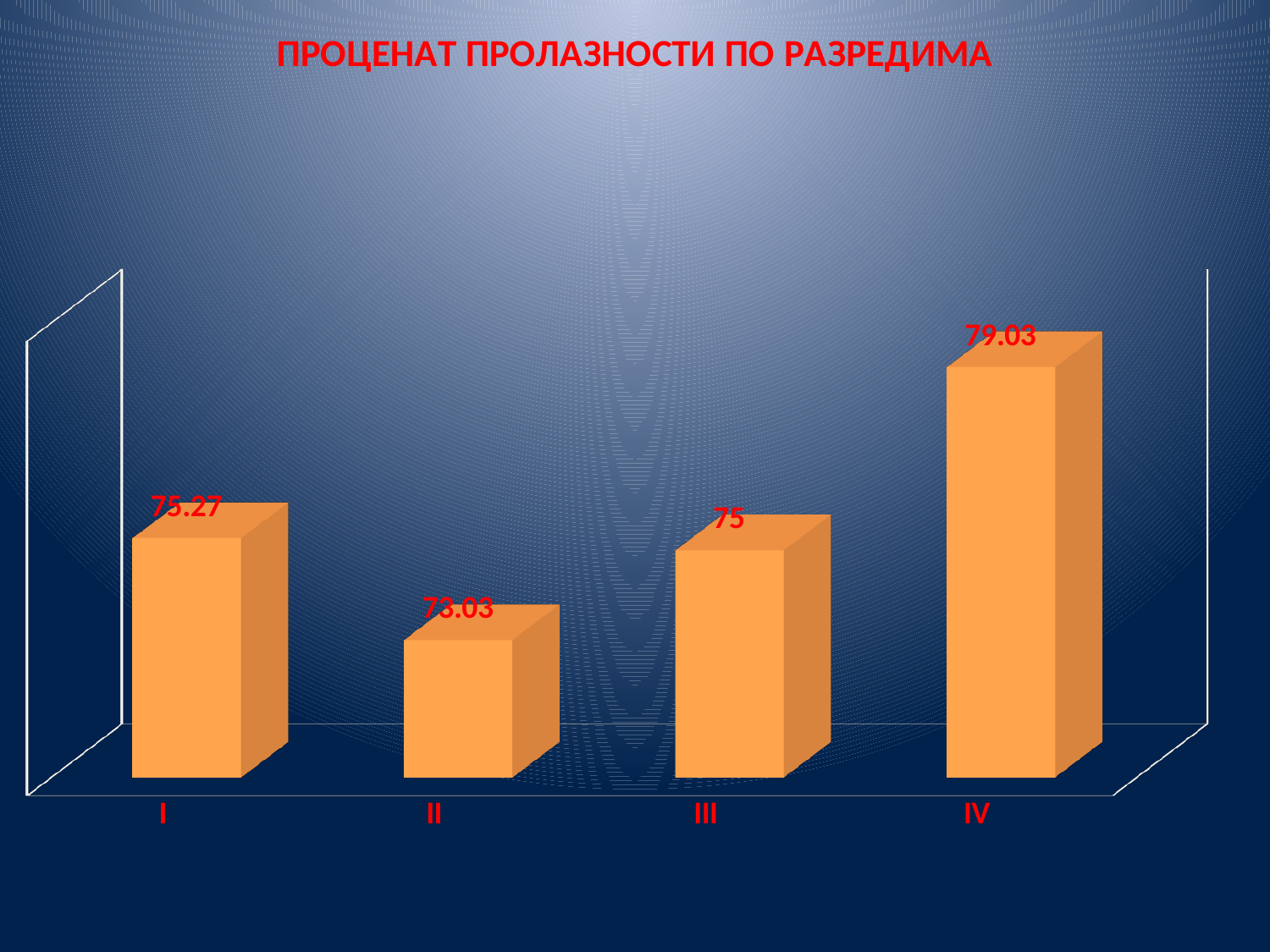
What is the difference between the values for I and III? 0.27 What kind of chart is shown on the slide? bar chart What is the value for category III? 75 What is the title of the chart? ПРОЦЕНАТ ПРОЛАЗНОСТИ ПО РАЗРЕДИМА What is the difference between the values for IV and II? 6 What is the value for category I? 75.27 What is the value for category IV? 79.03 Which category has the highest value? IV Which is larger, the value for I or the value for II? I Which category has the lowest value? II How many categories are shown in the chart? 4 What is the value for category II? 73.03